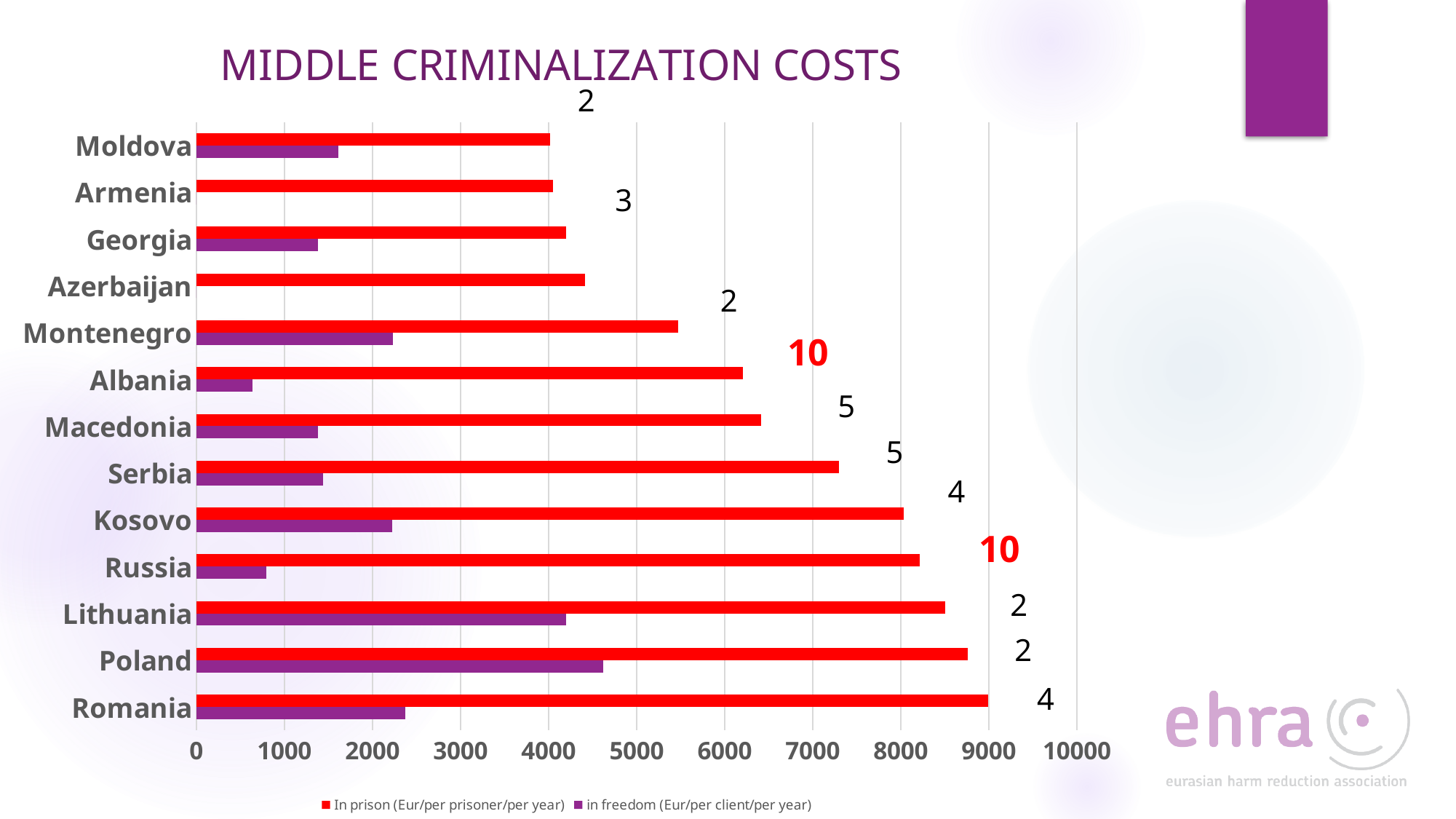
Is the In prison value for Montenegro greater or less than 5000? greater Is the in freedom value for Russia greater or less than 1000? less Is the In prison value for Albania greater or less than 6000? greater What kind of chart is shown on the slide? bar chart How many countries are listed on the vertical axis? 13 Which is larger, the In prison value for Lithuania or for Russia? Lithuania Which country has the highest value for In prison (Eur/per prisoner/per year)? Romania What is the title of the chart? MIDDLE CRIMINALIZATION COSTS Which colour represents the In prison (Eur/per prisoner/per year) series? red How many series does the legend list? 2 Which country has the highest value for in freedom (Eur/per client/per year)? Poland